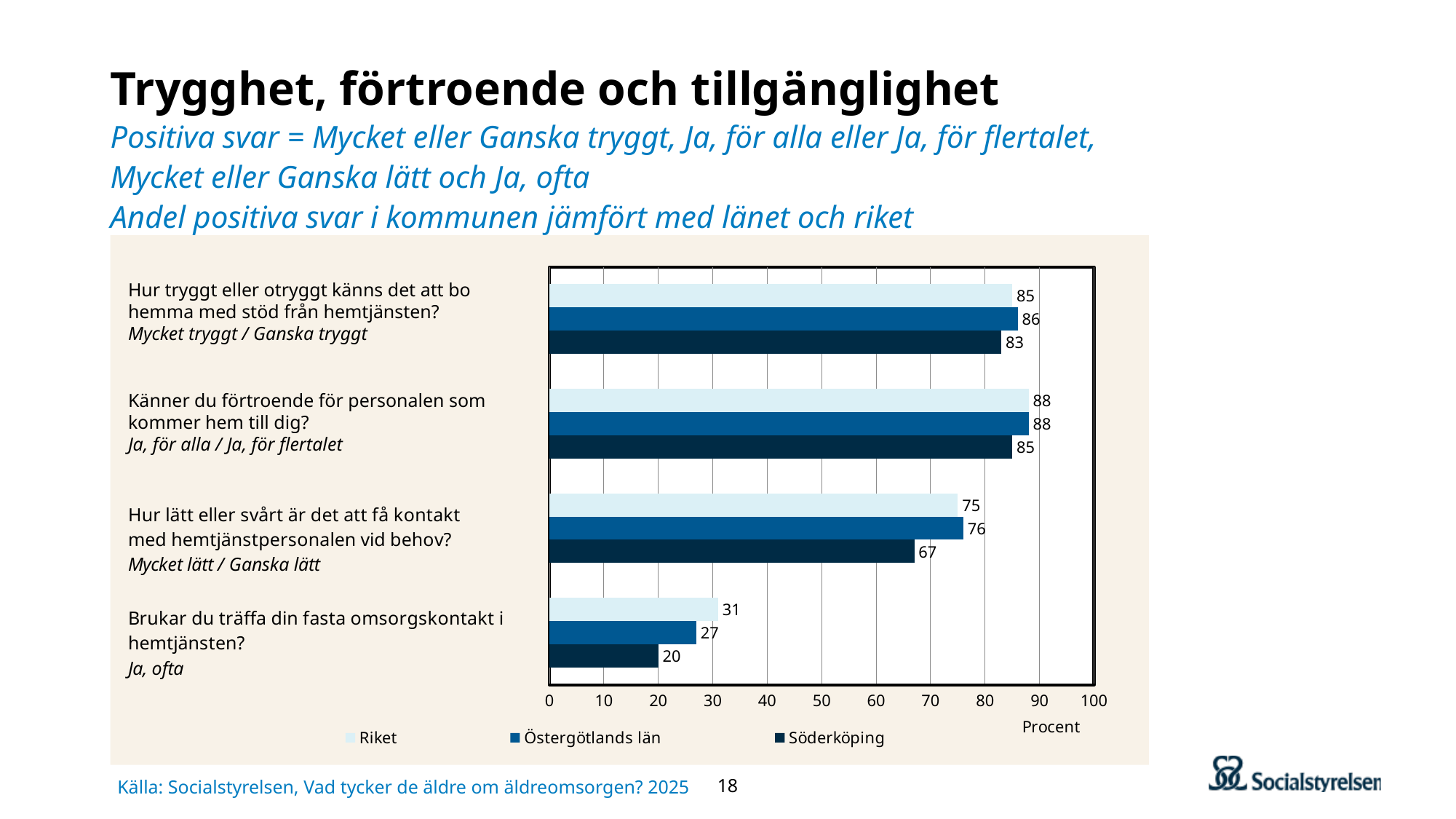
What is the value for Söderköping on the question "Hur lätt eller svårt är det att få kontakt med hemtjänstpersonalen vid behov?"? 67 What kind of chart is shown on the slide? Bar chart How many series does the legend list? 3 Which question has the highest value for Riket? Känner du förtroende för personalen som kommer hem till dig? On the question "Känner du förtroende för personalen som kommer hem till dig?", which is larger: Riket or Söderköping? Riket Which question has the lowest value for Söderköping? Brukar du träffa din fasta omsorgskontakt i hemtjänsten? How many questions (categories) are shown in the chart? 4 What unit is labelled on the horizontal axis of the chart? Procent What is the value for Riket on the question "Brukar du träffa din fasta omsorgskontakt i hemtjänsten?"? 31 What is the value for Östergötlands län on the question "Hur tryggt eller otryggt känns det att bo hemma med stöd från hemtjänsten?"? 86 What is the difference between Östergötlands län and Söderköping on the question "Hur lätt eller svårt är det att få kontakt med hemtjänstpersonalen vid behov?"? 9 What is the difference between Riket and Söderköping on the question "Brukar du träffa din fasta omsorgskontakt i hemtjänsten?"? 11